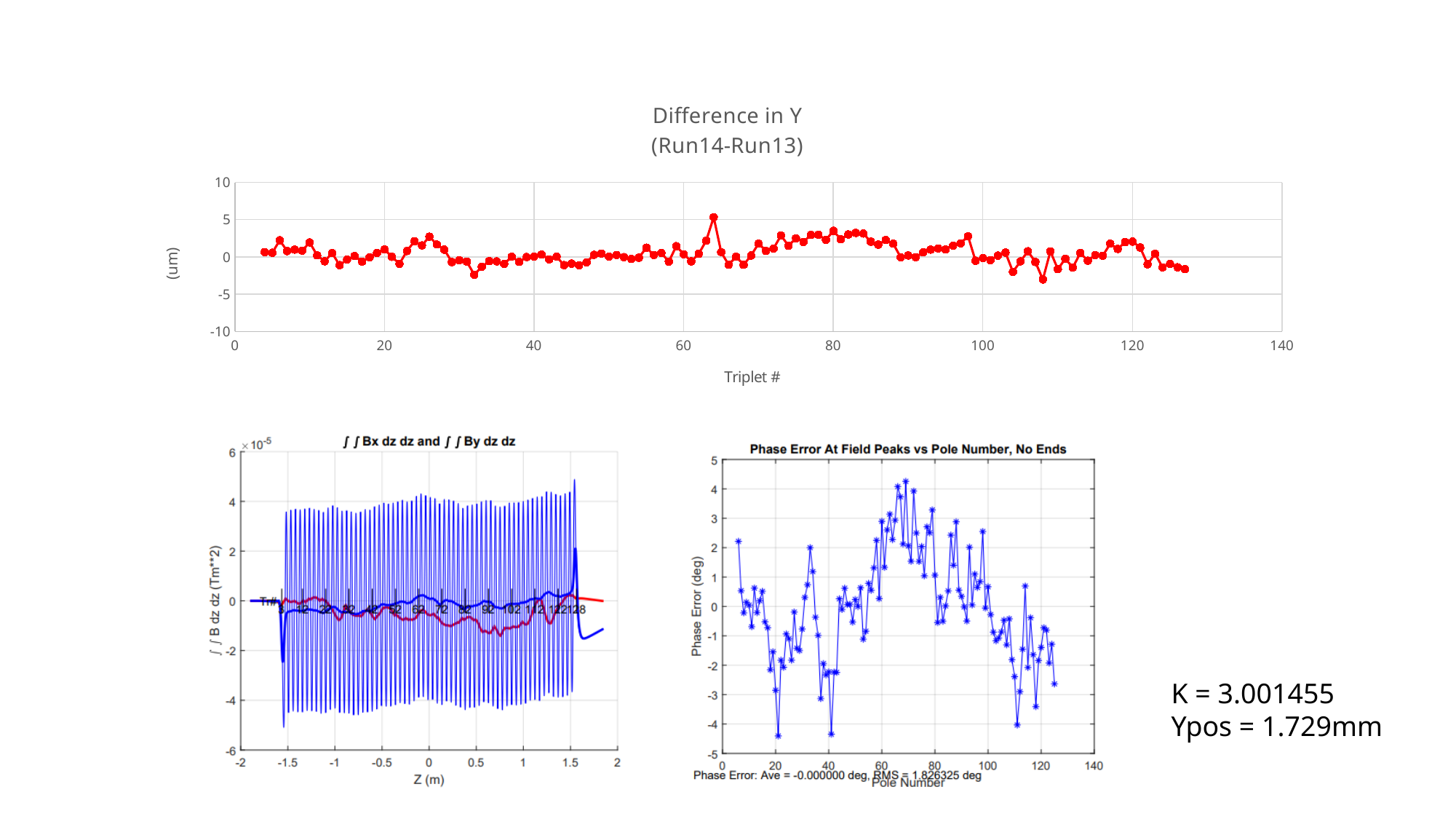
In the top chart 'Difference in Y (Run14-Run13)', is the lowest plotted value greater or less than -5? greater What is the title of the bottom-right chart? Phase Error At Field Peaks vs Pole Number, No Ends In the bottom-right chart 'Phase Error At Field Peaks vs Pole Number, No Ends', what is the y-axis label? Phase Error (deg) In the bottom-left chart '∫∫Bx dz dz and ∫∫By dz dz', what is the x-axis label? Z (m) In the bottom-right chart 'Phase Error At Field Peaks vs Pole Number, No Ends', is the lowest plotted phase error greater or less than -3? less In the top chart 'Difference in Y (Run14-Run13)', what is the maximum value shown on the y-axis? 10 In the top chart 'Difference in Y (Run14-Run13)', what unit is shown on the y-axis? um In the top chart 'Difference in Y (Run14-Run13)', is the highest plotted value greater or less than 0? greater In the bottom-right chart 'Phase Error At Field Peaks vs Pole Number, No Ends', what RMS value is printed below the plot? 1.826325 deg In the bottom-right chart 'Phase Error At Field Peaks vs Pole Number, No Ends', what average (Ave) value is printed below the plot? -0.000000 deg